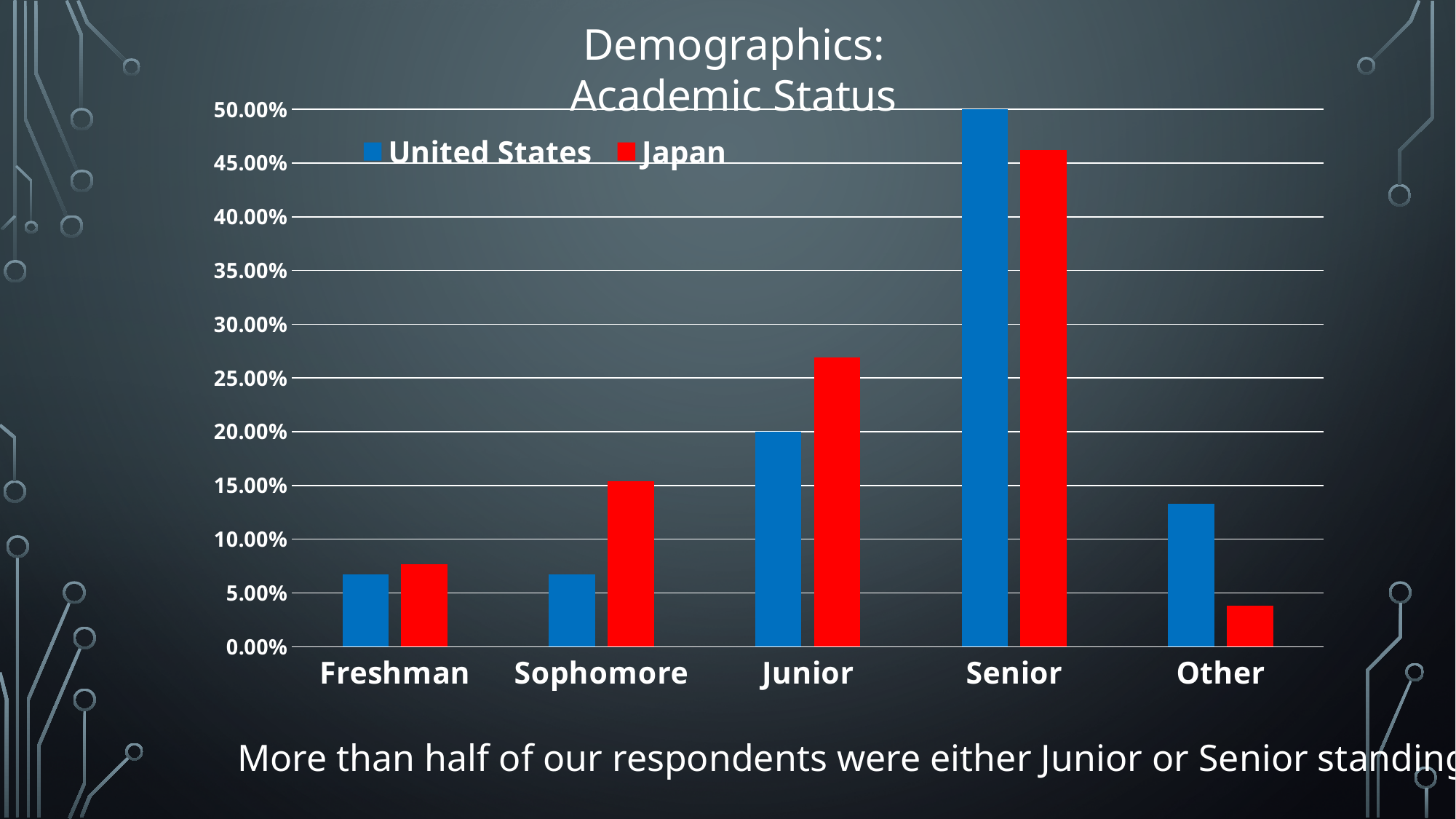
Which category has the lowest value for Japan? Other What kind of chart is shown on the slide? bar chart Which colour represents Japan in the chart? red What is the value for United States in the Junior category? 20.00% Which category has the highest value for Japan? Senior Is the value for Japan in the Other category greater or less than 5.00%? less Which is larger in the Junior category, United States or Japan? Japan How many academic status categories are shown on the x axis? 5 How many series does the legend list? 2 Which is larger in the Other category, United States or Japan? United States Which category has the highest value for United States? Senior